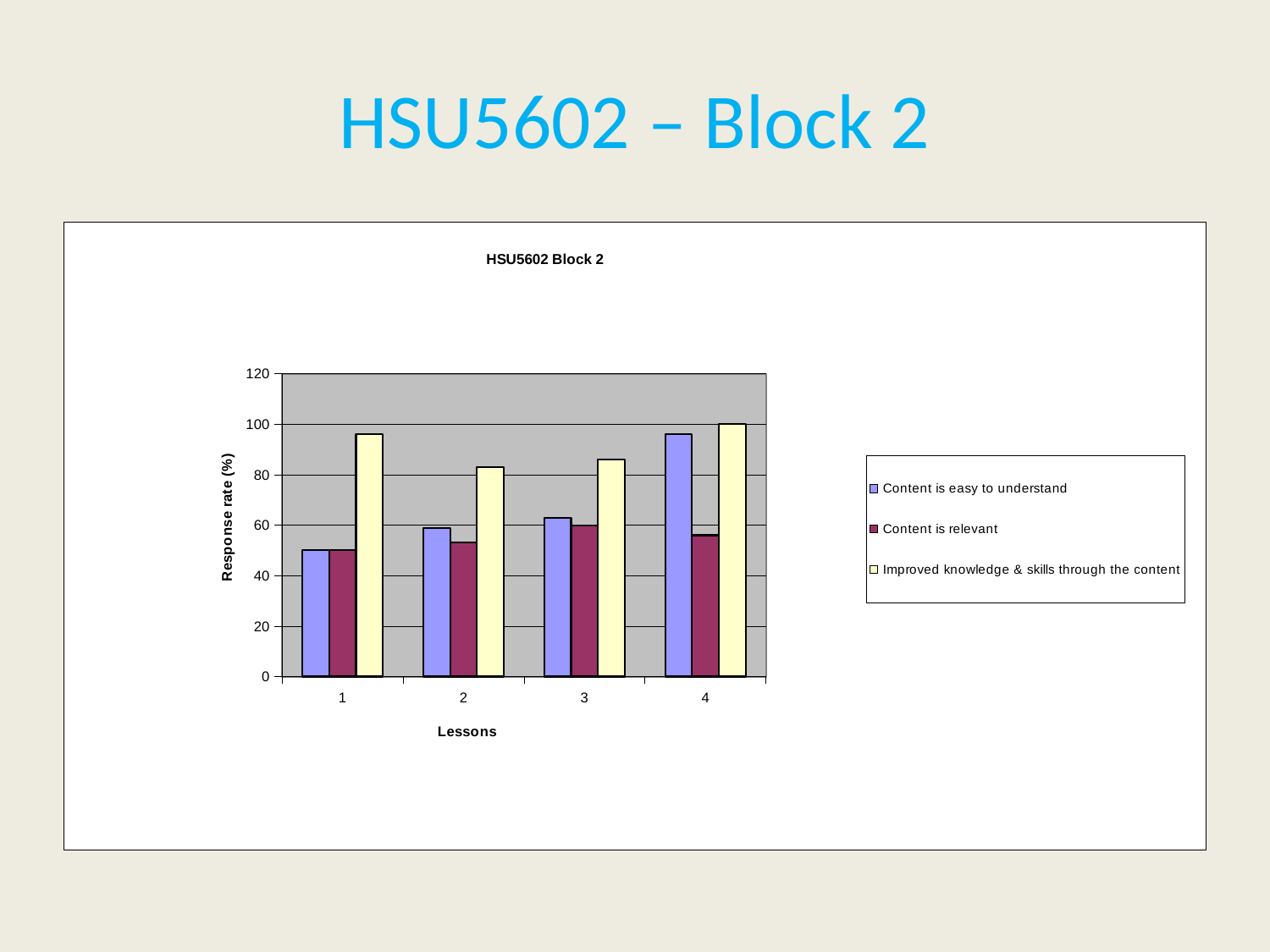
What kind of chart is shown on the slide? bar chart Is the value for 'Content is relevant' in lesson 2 greater or less than 60? less Which lesson has the lowest value for 'Improved knowledge & skills through the content'? 2 Does the value for 'Content is easy to understand' rise or fall from lesson 1 to lesson 4? rise Which lesson has the highest value for 'Improved knowledge & skills through the content'? 4 How many series does the chart's legend list? 3 What is the label on the y axis of the chart? Response rate (%) How many lessons are shown on the x axis of the chart? 4 For lesson 1, which is larger: 'Content is relevant' or 'Improved knowledge & skills through the content'? Improved knowledge & skills through the content Which lesson has the highest value for 'Content is easy to understand'? 4 Is the value for 'Content is easy to understand' in lesson 4 greater or less than 80? greater For lesson 4, which is larger: 'Content is easy to understand' or 'Content is relevant'? Content is easy to understand